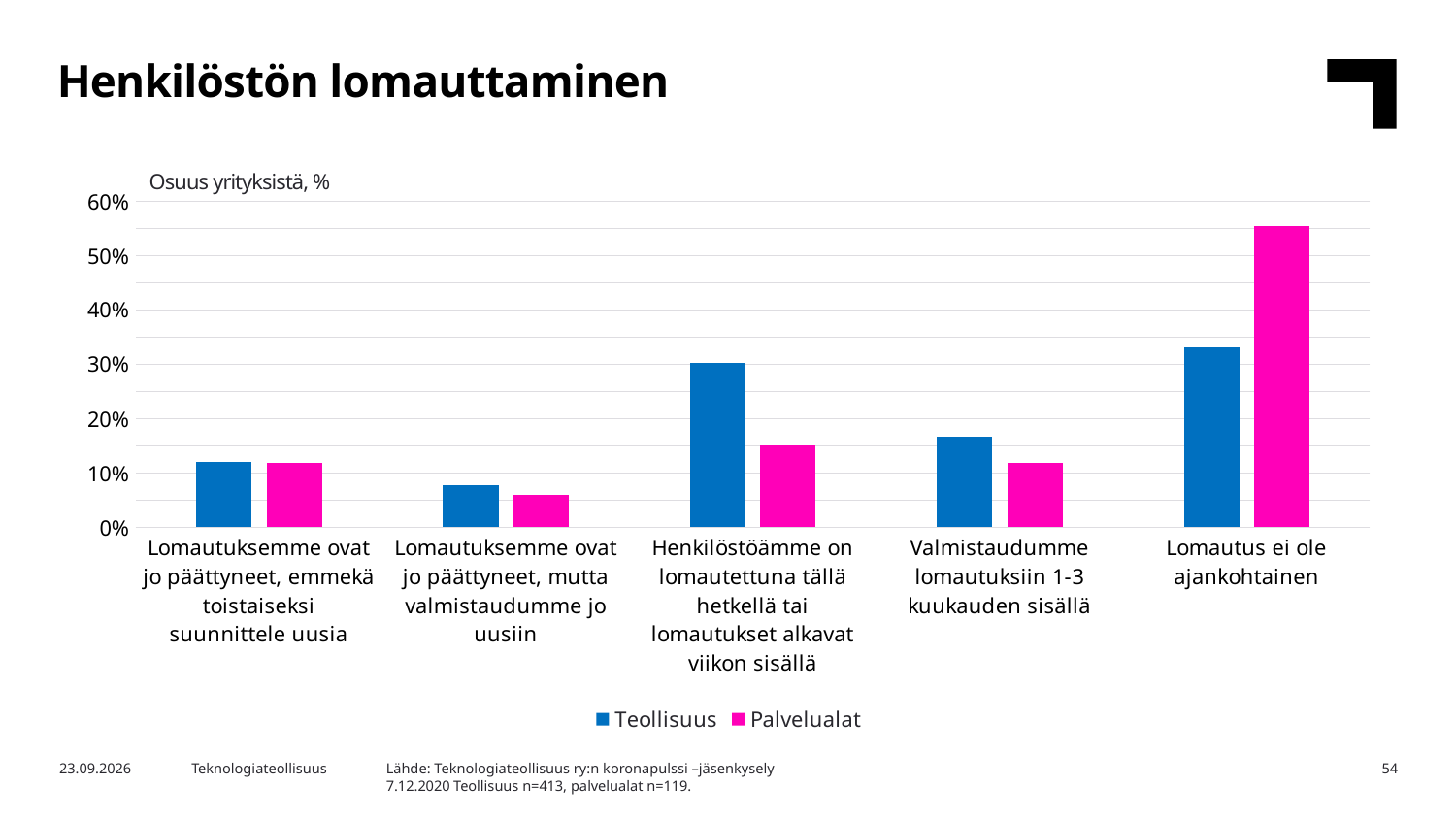
Which category has the highest value for Palvelualat? Lomautus ei ole ajankohtainen How many series does the legend list? 2 For 'Henkilöstöämme on lomautettuna tällä hetkellä tai lomautukset alkavat viikon sisällä', which series has the larger value, Teollisuus or Palvelualat? Teollisuus Is the Palvelualat value for 'Lomautus ei ole ajankohtainen' greater or less than 50%? greater What is the title of the slide? Henkilöstön lomauttaminen Is the Teollisuus value for 'Henkilöstöämme on lomautettuna tällä hetkellä tai lomautukset alkavat viikon sisällä' greater or less than 20%? greater For 'Lomautus ei ole ajankohtainen', which series has the larger value, Teollisuus or Palvelualat? Palvelualat Is the Teollisuus value for 'Valmistaudumme lomautuksiin 1-3 kuukauden sisällä' greater or less than 20%? less What kind of chart is shown on the slide? bar chart Which category has the lowest value for Palvelualat? Lomautuksemme ovat jo päättyneet, mutta valmistaudumme jo uusiin Which category has the lowest value for Teollisuus? Lomautuksemme ovat jo päättyneet, mutta valmistaudumme jo uusiin How many categories are shown on the x axis? 5